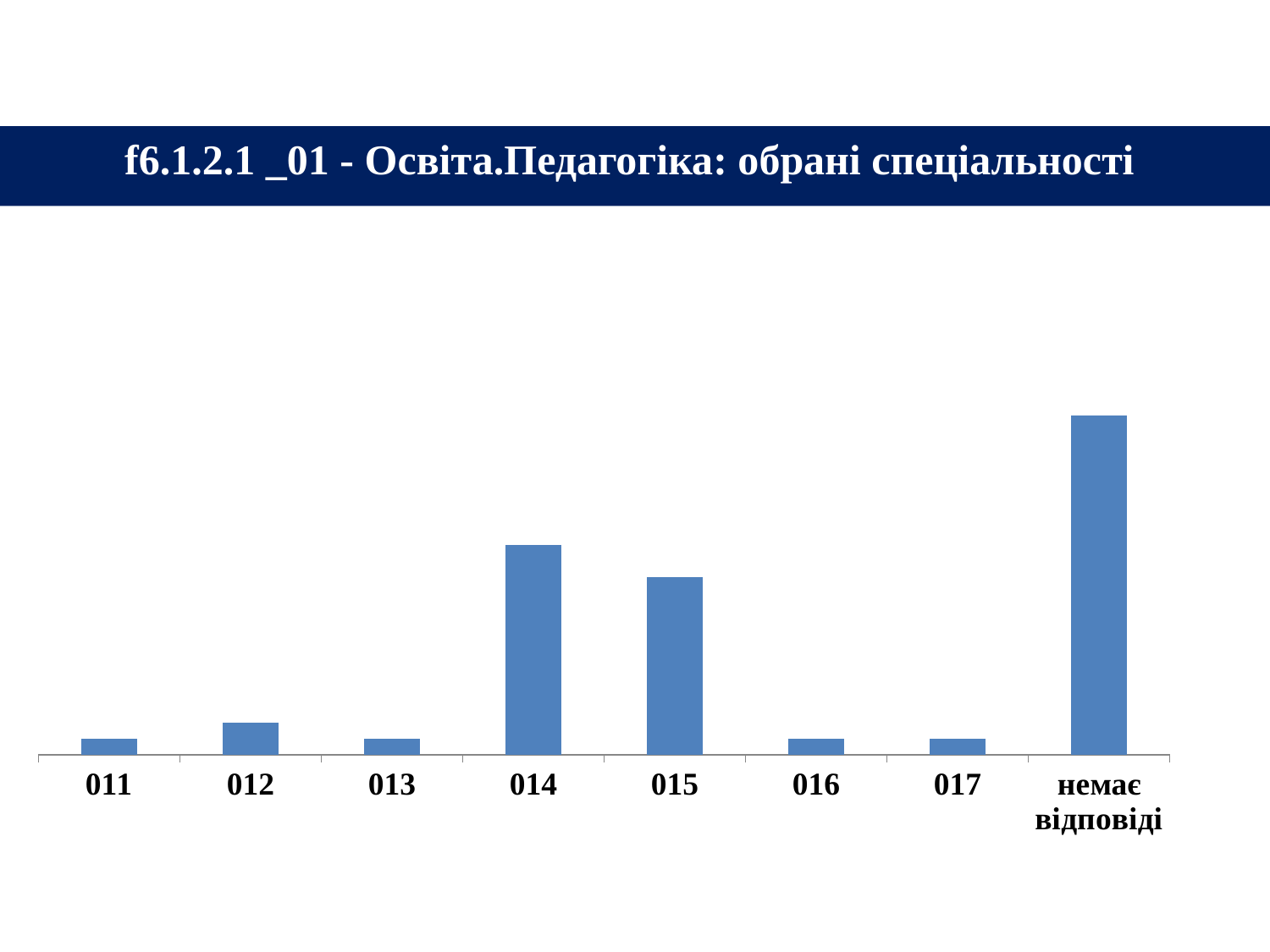
Which is larger, the value for 012 or the value for 011? 012 Which category has the highest bar? немає відповіді Which is larger, the value for 014 or the value for 015? 014 Which is larger, the value for немає відповіді or the value for 014? немає відповіді What is the title of the slide? f6.1.2.1 _01 - Освіта.Педагогіка: обрані спеціальності Among the numbered specialities 011–017, which has the highest bar? 014 How many categories are shown on the x axis? 8 What colour are the bars in the chart? blue What kind of chart is shown on the slide? bar chart